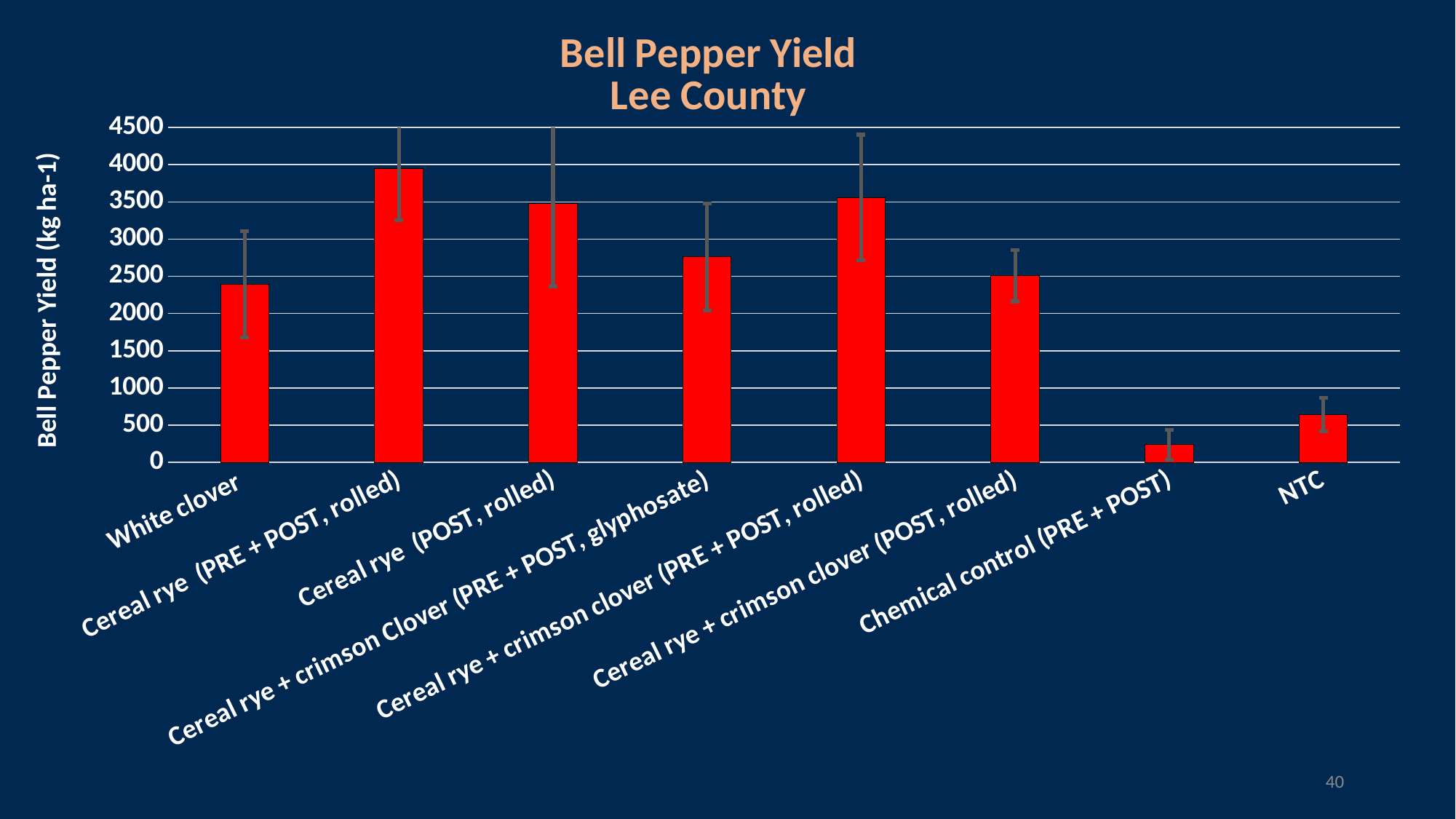
Which treatment has the highest bell pepper yield? Cereal rye (PRE + POST, rolled) Is the yield for Cereal rye (POST, rolled) greater or less than 3000? greater Which has the larger yield: Cereal rye (POST, rolled) or White clover? Cereal rye (POST, rolled) Is the yield for Chemical control (PRE + POST) greater or less than 500? less What kind of chart is shown on the slide? Bar chart Is the yield for NTC greater or less than 500? greater Which treatment has the lowest bell pepper yield? Chemical control (PRE + POST) How many treatment categories are plotted on the x axis? 8 What is the label of the y axis? Bell Pepper Yield (kg ha-1) Which has the larger yield: Cereal rye + crimson clover (PRE + POST, rolled) or Cereal rye + crimson Clover (PRE + POST, glyphosate)? Cereal rye + crimson clover (PRE + POST, rolled)